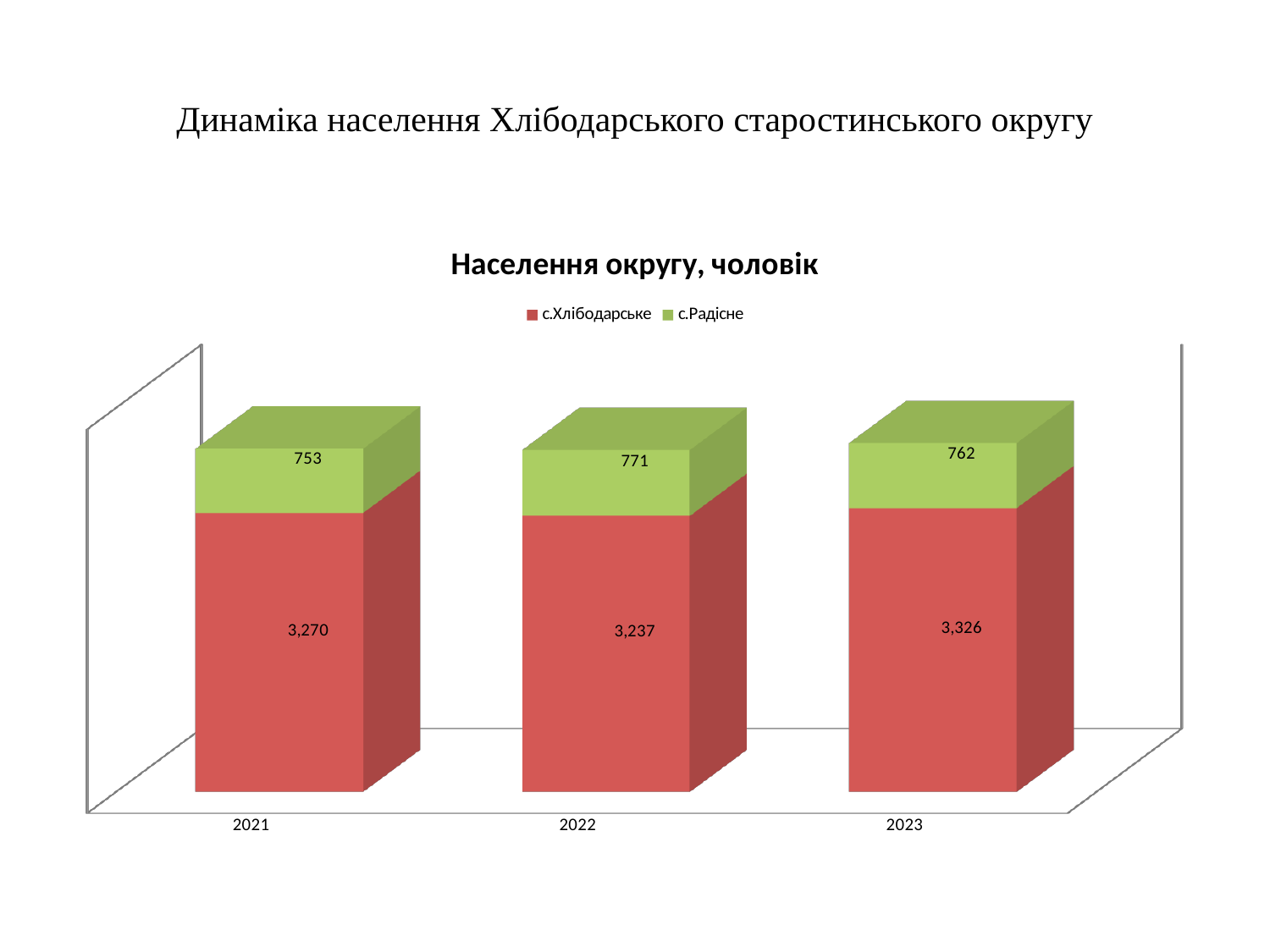
What is the value for с.Радісне in 2022? 771 What is the value for с.Хлібодарське in 2023? 3,326 What kind of chart is shown on the slide? Stacked bar chart In which year is the value for с.Хлібодарське the highest? 2023 Which is larger: the с.Радісне value in 2022 or in 2023? 2022 How many series does the legend list? 2 In which year is the value for с.Радісне the lowest? 2021 How many years are shown on the x axis? 3 What is the total of the stacked bar for 2021? 4,023 What is the value for с.Хлібодарське in 2021? 3,270 What is the title of the chart? Населення округу, чоловік What is the difference between the с.Хлібодарське values in 2023 and 2022? 89